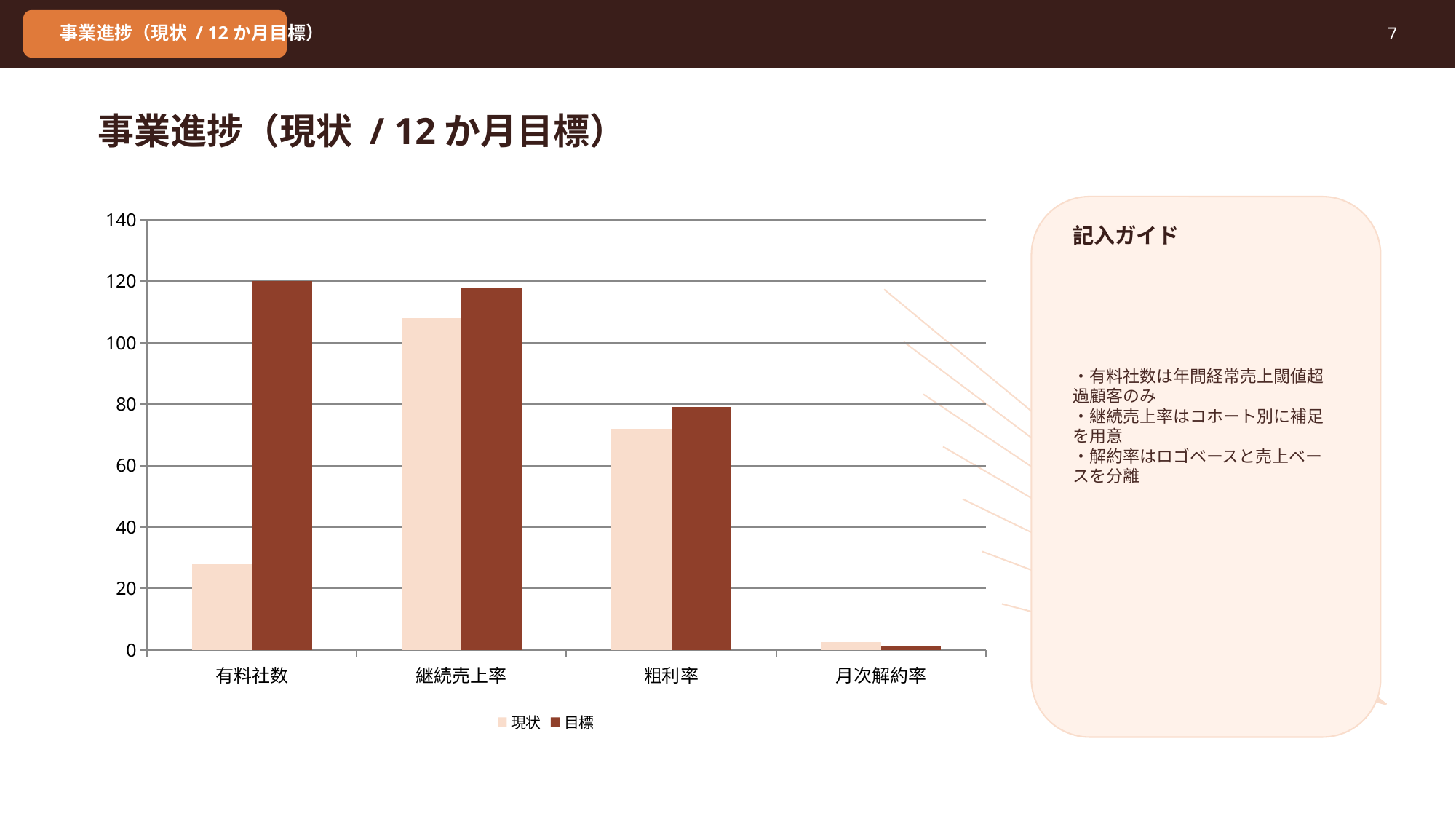
How many categories are shown on the x axis of the chart? 4 Which category has the lowest 現状 value? 月次解約率 How many series does the chart legend list? 2 Which category has the highest 現状 value? 継続売上率 Is the 現状 value for 継続売上率 greater or less than 100? greater Is the 目標 value for 粗利率 greater or less than 100? less Which category has the highest 目標 value? 有料社数 What are the two series named in the chart legend? 現状 and 目標 For 粗利率, which is larger, the 現状 value or the 目標 value? 目標 For 有料社数, which is larger, the 現状 value or the 目標 value? 目標 Is the 現状 value for 有料社数 greater or less than 40? less What kind of chart is shown on the slide? bar chart